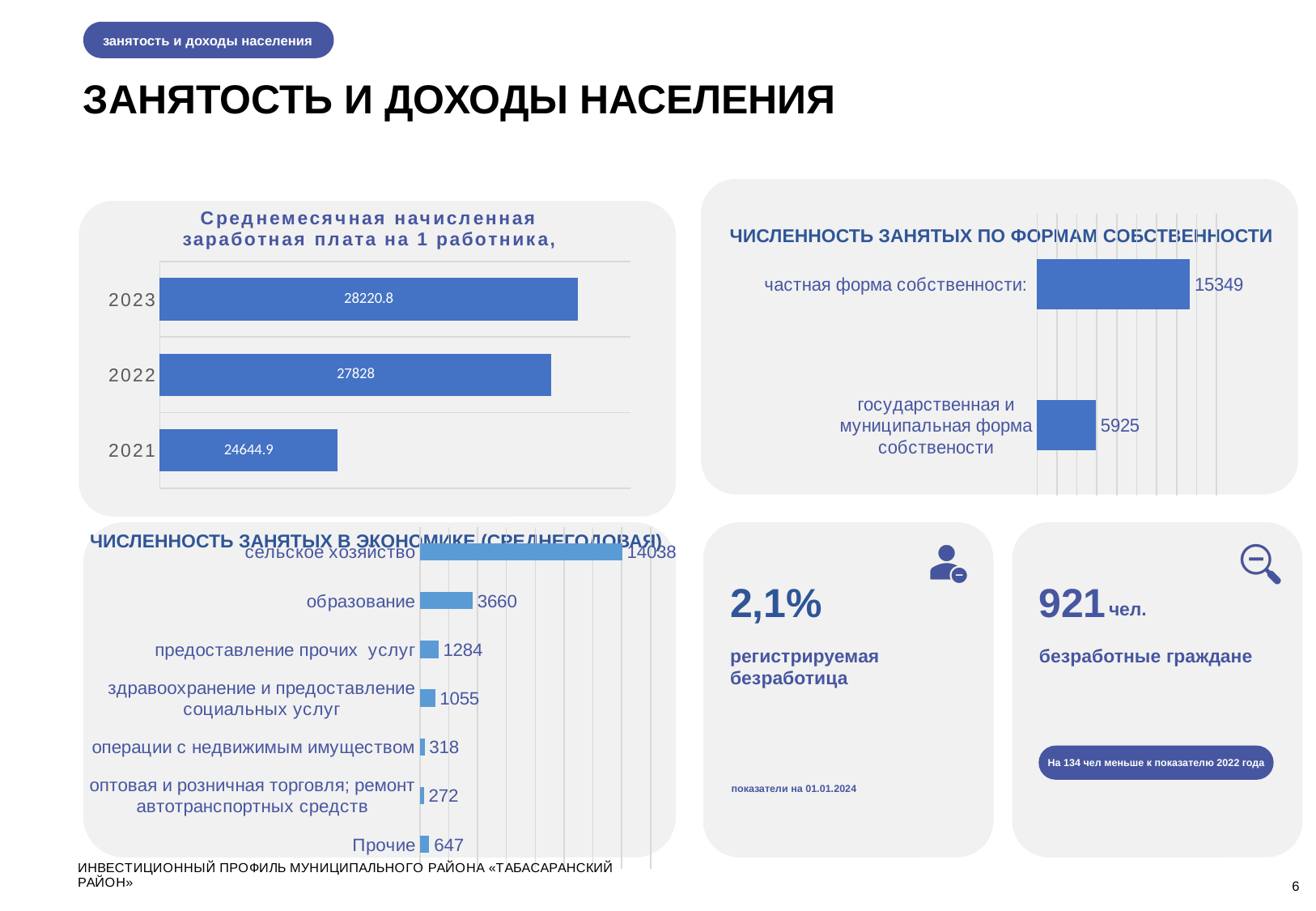
On the chart 'Численность занятых в экономике (среднегодовая)', which category has the highest value? сельское хозяйство On the chart 'Численность занятых в экономике (среднегодовая)', how many categories are shown? 7 On the chart 'Среднемесячная начисленная заработная плата на 1 работника', what is the value for 2021? 24644.9 On the chart 'Численность занятых по формам собственности', what is the difference between the private and the state/municipal values? 9424 On the chart 'Численность занятых в экономике (среднегодовая)', which is larger: 'операции с недвижимым имуществом' or 'Прочие'? Прочие On the chart 'Среднемесячная начисленная заработная плата на 1 работника', what is the difference between the 2022 and 2021 values? 3183.1 On the chart 'Среднемесячная начисленная заработная плата на 1 работника', what is the value for 2023? 28220.8 What type of chart is 'Численность занятых по формам собственности'? bar chart On the chart 'Численность занятых по формам собственности', what is the value for 'частная форма собственности'? 15349 On the chart 'Среднемесячная начисленная заработная плата на 1 работника', do the values rise or fall from 2021 to 2023? rise On the chart 'Численность занятых в экономике (среднегодовая)', what is the value for 'образование'? 3660 On the chart 'Среднемесячная начисленная заработная плата на 1 работника', which year has the lowest value? 2021